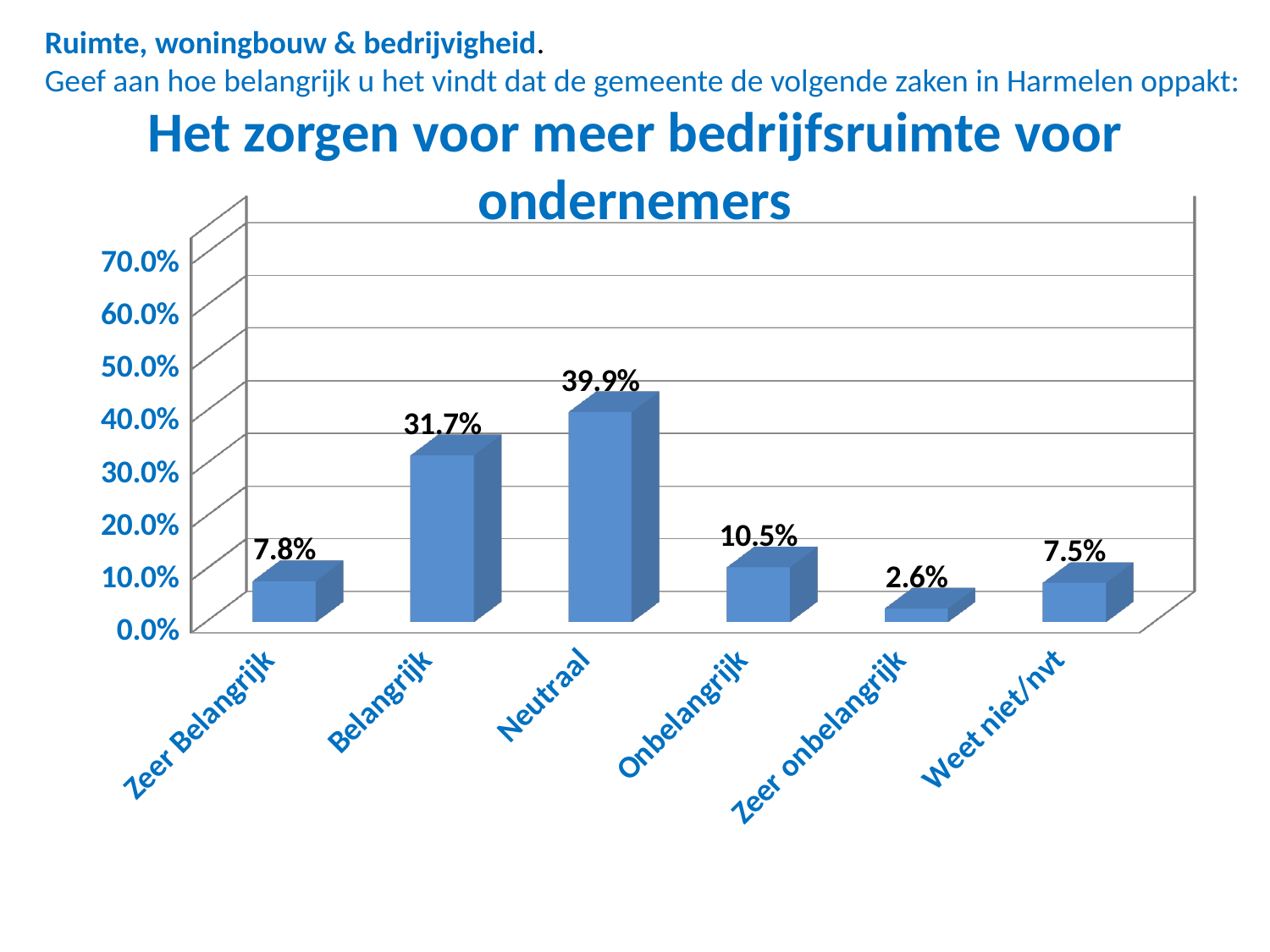
What is the difference between the values for Neutraal and Belangrijk? 8.2% What is the value for Weet niet/nvt? 7.5% Which is larger, the value for Belangrijk or the value for Onbelangrijk? Belangrijk Which category has the highest value? Neutraal What is the title of the chart? Het zorgen voor meer bedrijfsruimte voor ondernemers Which category has the lowest value? Zeer onbelangrijk What is the value for Neutraal? 39.9% What kind of chart is shown on the slide? bar chart How many categories are shown on the x axis? 6 What is the value for Zeer Belangrijk? 7.8% Is the value for Belangrijk greater or less than 30.0%? greater What is the difference between the values for Onbelangrijk and Zeer onbelangrijk? 7.9%